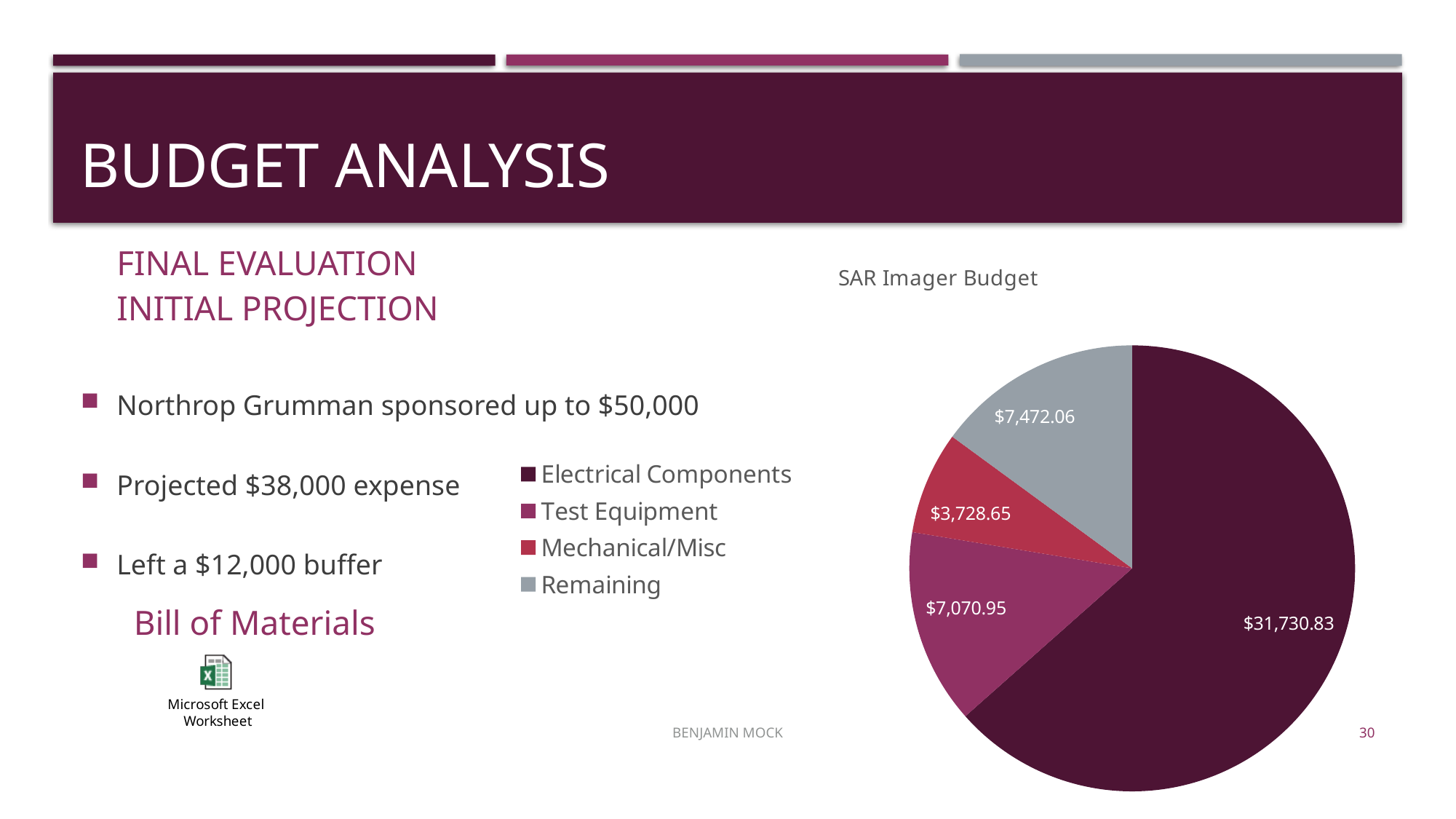
What is the title of the chart on the slide? SAR Imager Budget Which category has the smallest slice in the SAR Imager Budget pie chart? Mechanical/Misc Which category has the largest slice in the SAR Imager Budget pie chart? Electrical Components What is the value of the Remaining slice in the SAR Imager Budget pie chart? $7,472.06 What is the value of the Electrical Components slice in the SAR Imager Budget pie chart? $31,730.83 What is the difference between the Test Equipment and Mechanical/Misc values in the SAR Imager Budget pie chart? $3,342.30 What type of chart is used to show the SAR Imager Budget? Pie chart What is the difference between the Electrical Components and Test Equipment values in the SAR Imager Budget pie chart? $24,659.88 In the SAR Imager Budget pie chart, which is larger: Electrical Components or Remaining? Electrical Components What is the value of the Mechanical/Misc slice in the SAR Imager Budget pie chart? $3,728.65 What is the value of the Test Equipment slice in the SAR Imager Budget pie chart? $7,070.95 How many slices does the SAR Imager Budget pie chart have? 4